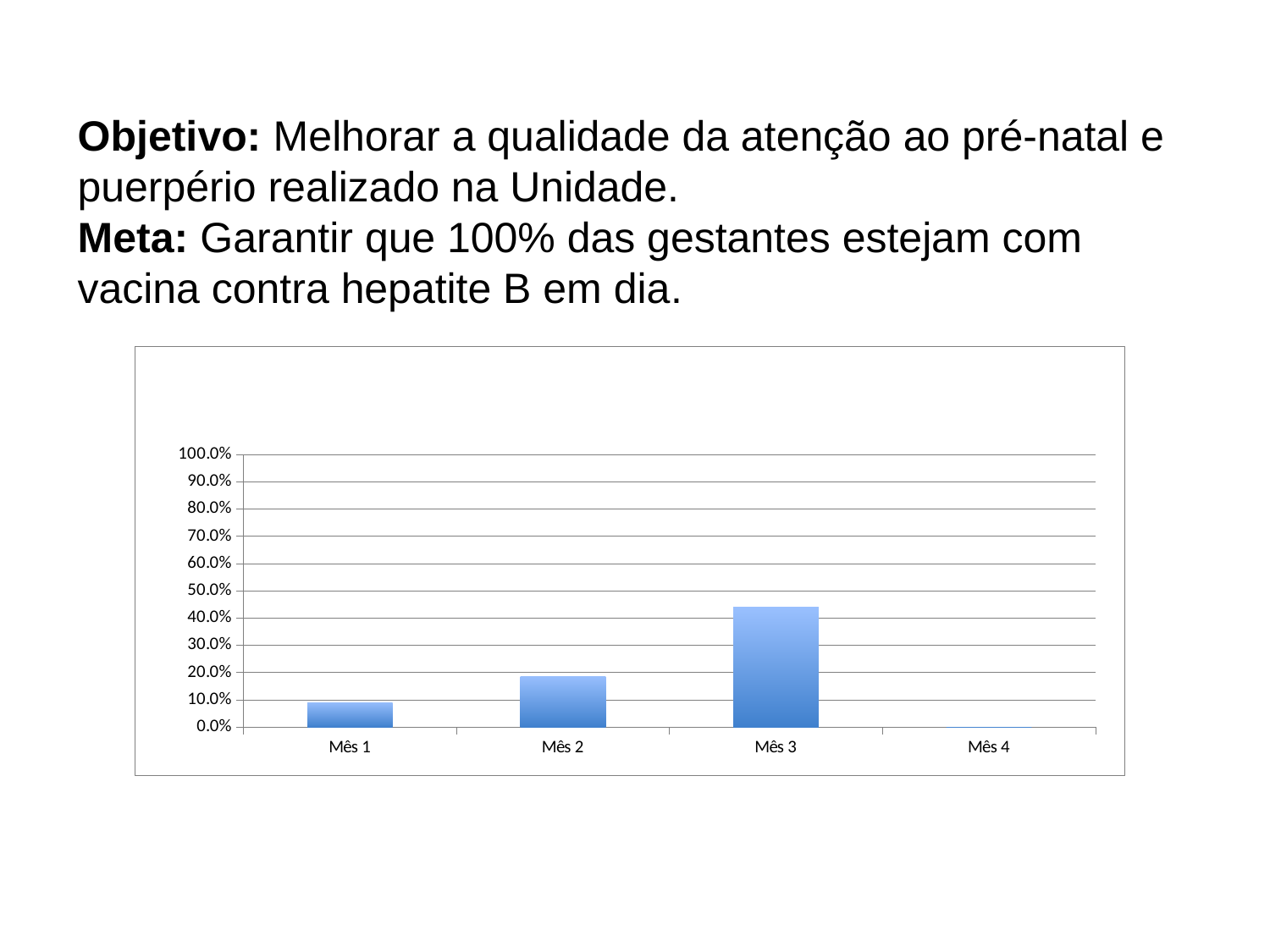
Which month has the highest bar in the chart? Mês 3 Which is larger, the value for Mês 2 or the value for Mês 3? Mês 3 Is the value for Mês 2 greater or less than 10.0%? greater Is the value for Mês 3 greater or less than 50.0%? less Is the value for Mês 3 greater or less than 40.0%? greater What kind of chart is shown on the slide? bar chart What is the highest value shown on the y axis of the chart? 100.0% Do the values rise or fall from Mês 1 to Mês 3? rise Which is larger, the value for Mês 1 or the value for Mês 2? Mês 2 How many categories are shown on the x axis of the chart? 4 Among Mês 1, Mês 2 and Mês 3, which has the lowest value? Mês 1